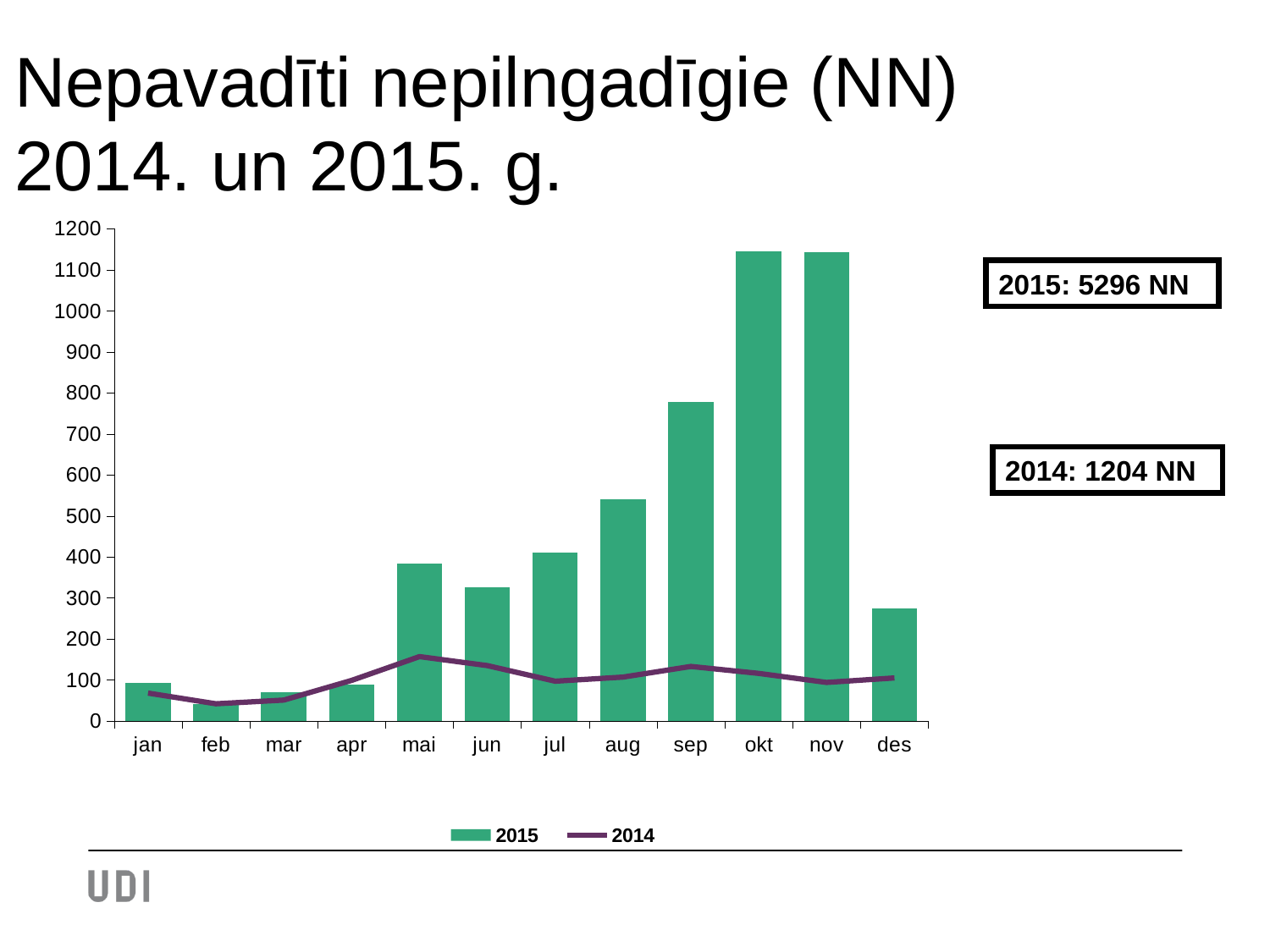
Is the 2015 value for sep greater or less than 700? greater What colour are the bars for the 2015 series? Green How many series does the legend list? 2 According to the text box on the slide, what is the total number of NN for 2015? 5296 NN Which month has the lowest 2015 bar? feb Do the 2015 bars generally rise or fall from jan to okt? rise Is the 2015 value for des greater or less than 300? less Is the 2014 value for mai greater or less than 100? greater How many months are shown along the x axis? 12 For okt, which series has the larger value, 2015 or 2014? 2015 What kind of chart is shown on the slide? A combined bar and line chart